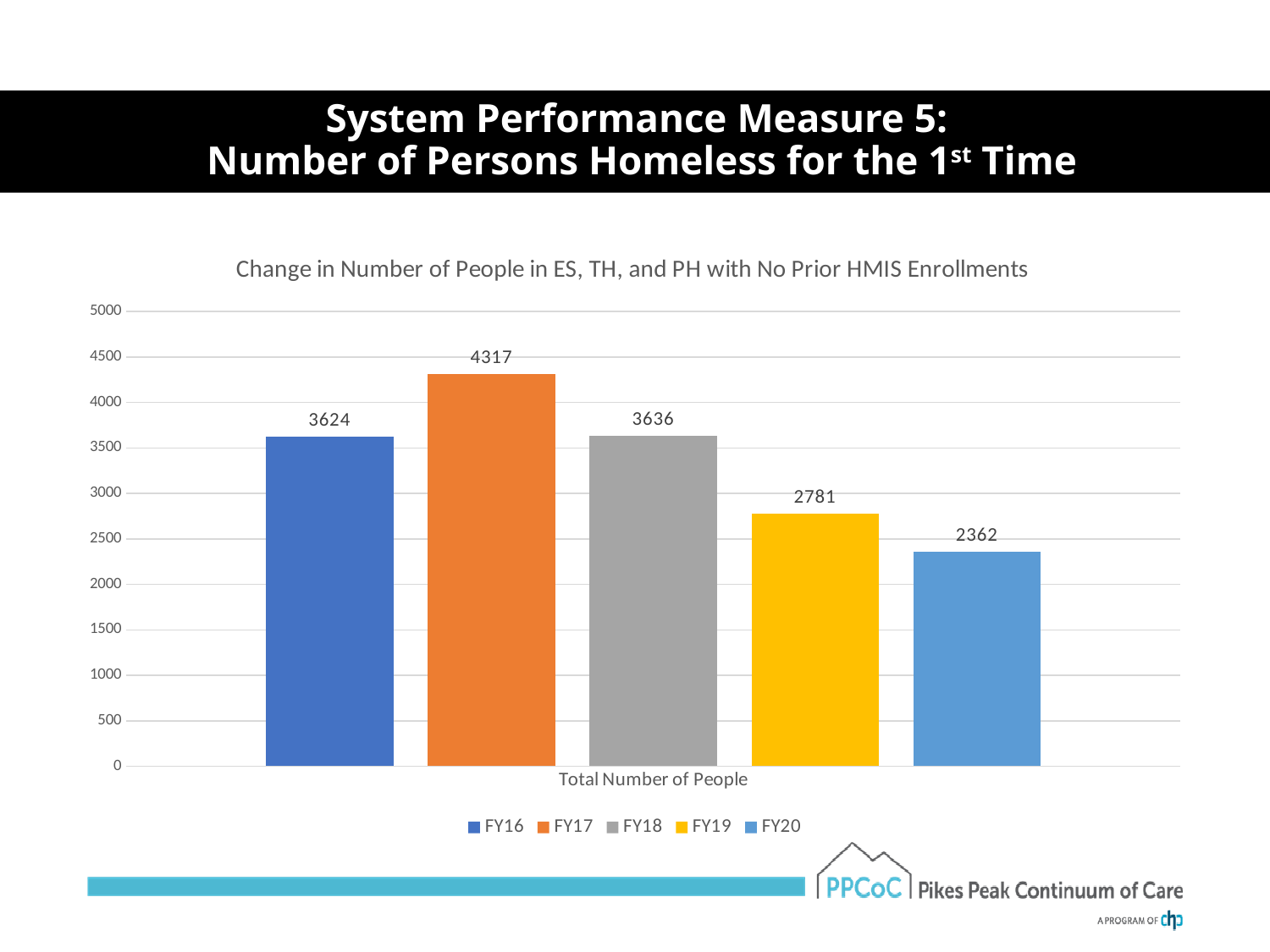
What is the value for FY19? 2781 What is the title of the chart? Change in Number of People in ES, TH, and PH with No Prior HMIS Enrollments What is the value for FY20? 2362 What kind of chart is shown on the slide? bar chart What is the difference between the FY18 and FY16 values? 12 Which fiscal year has the lowest value? FY20 How many series does the legend list? 5 What is the value for FY17? 4317 Which is larger, the value for FY16 or the value for FY19? FY16 Which fiscal year has the highest value? FY17 Is the value for FY19 greater or less than 3000? less What is the difference between the FY17 and FY20 values? 1955